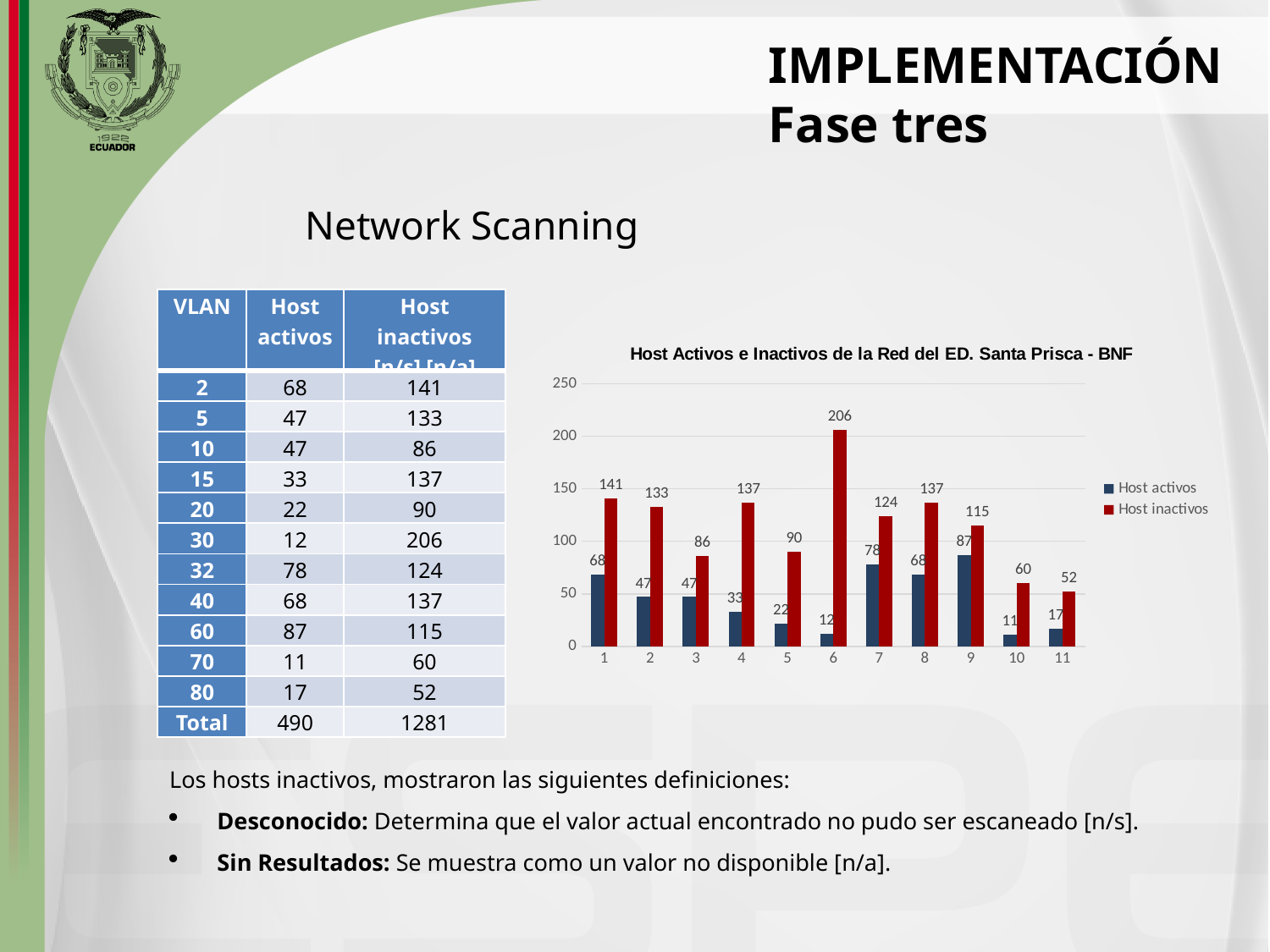
Is the Host inactivos value for category 1 greater or less than 100? greater Which is larger for category 7: Host activos or Host inactivos? Host inactivos Which category has the highest Host inactivos value? 6 What is the title of the chart? Host Activos e Inactivos de la Red del ED. Santa Prisca - BNF What is the value of Host inactivos for category 6? 206 How many series does the chart legend list? 2 What is the value of Host activos for category 9? 87 What is the value of Host inactivos for category 3? 86 Which category has the lowest Host activos value? 10 What is the difference between Host inactivos and Host activos for category 6? 194 What kind of chart is shown on the slide? bar chart How many categories are shown on the x axis of the chart? 11